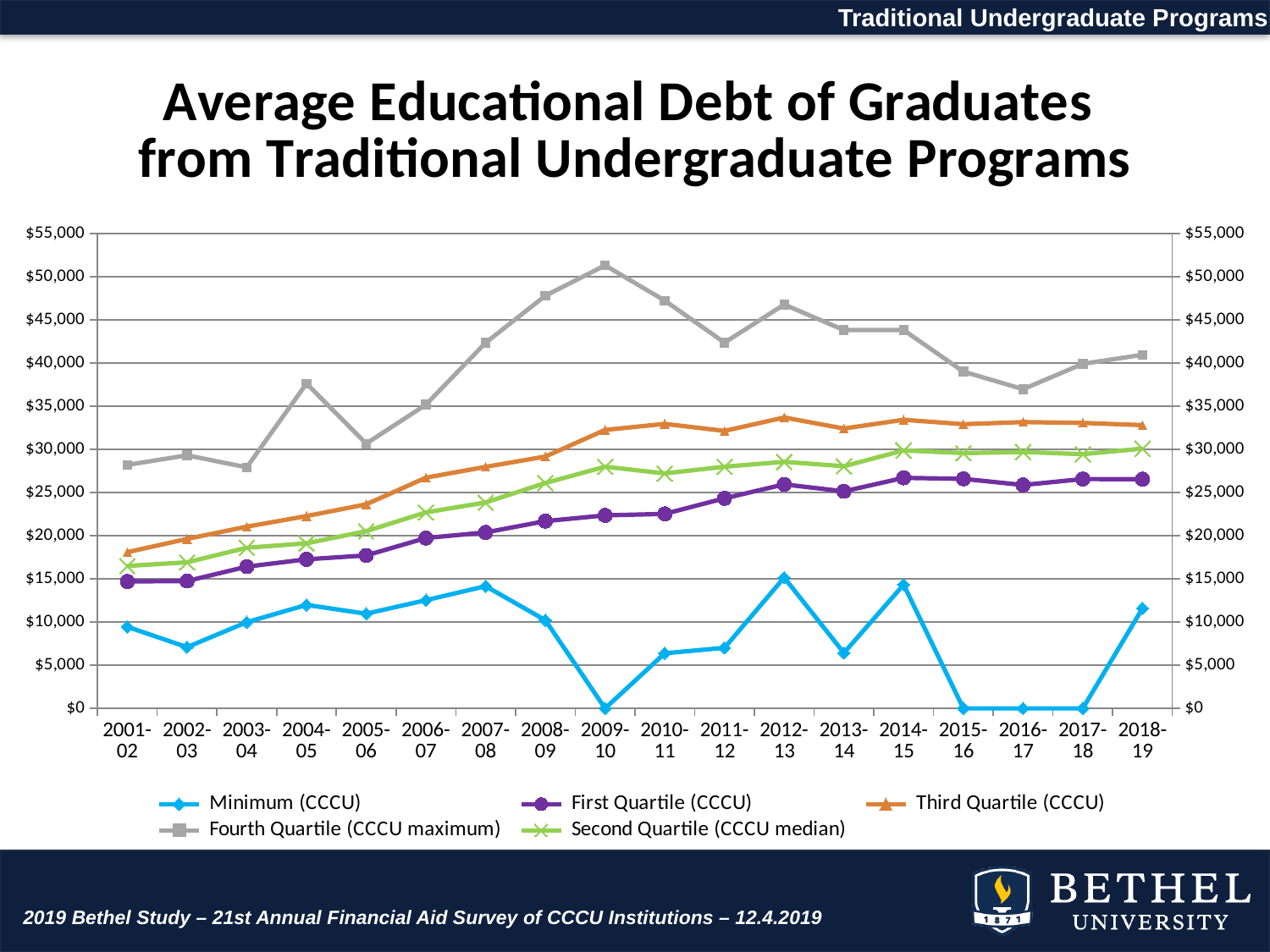
In which year does Fourth Quartile (CCCU maximum) reach its highest value? 2009-10 Is the value for Third Quartile (CCCU) in 2018-19 greater or less than $30,000? greater What is the value of Minimum (CCCU) for 2009-10? $0 How many academic years are plotted along the x axis? 18 Which series has the lowest values across the chart? Minimum (CCCU) In how many years is the Minimum (CCCU) value $0? 4 What is the value of Minimum (CCCU) for 2016-17? $0 How many series does the legend list? 5 Does the Third Quartile (CCCU) series generally rise or fall from 2001-02 to 2012-13? rise Is the value for Fourth Quartile (CCCU maximum) in 2009-10 greater or less than $50,000? greater What kind of chart is shown on the slide? line chart Which is larger for Minimum (CCCU): the value in 2012-13 or the value in 2013-14? 2012-13